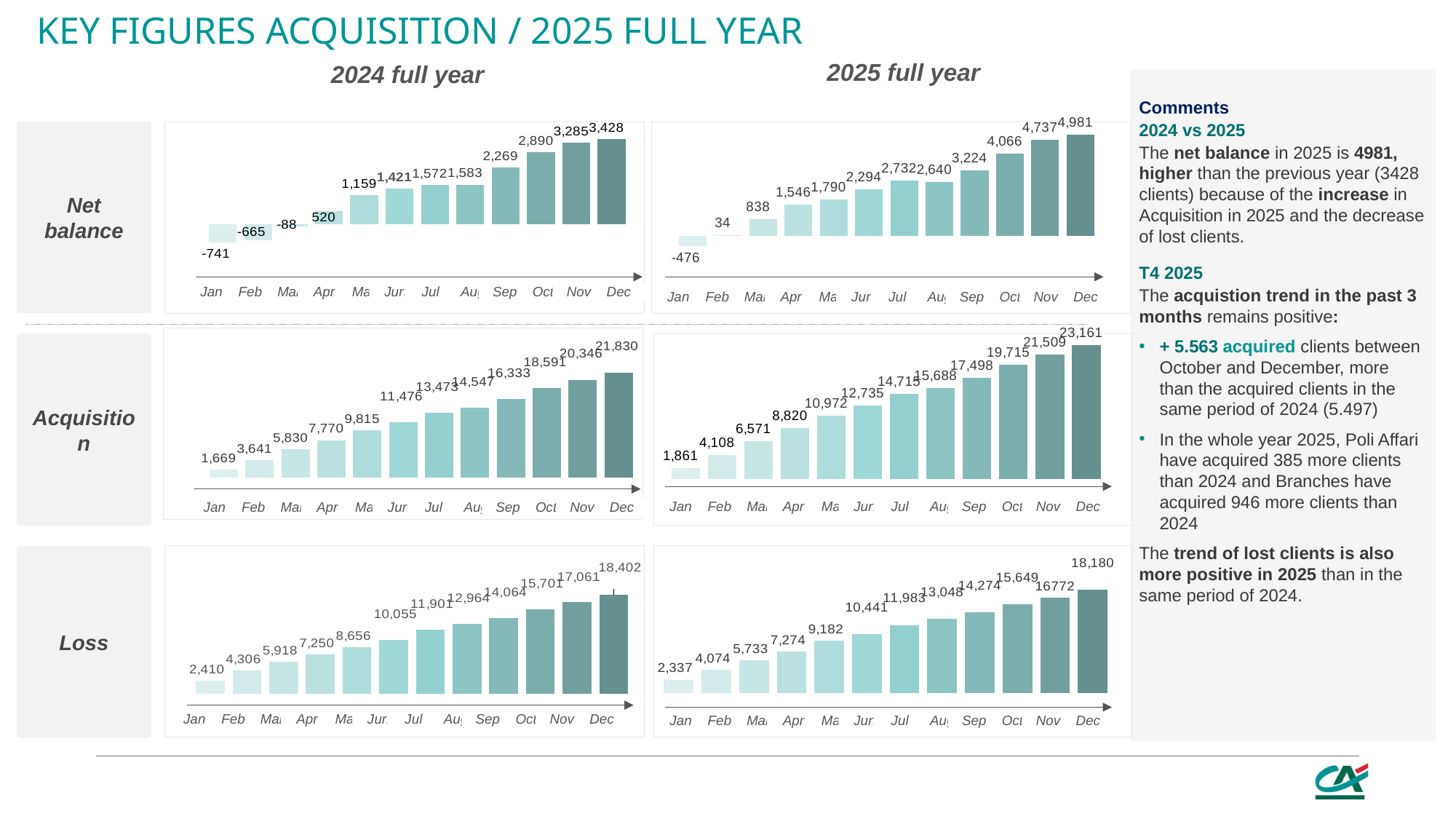
In the Net balance chart for 2025 full year, what is the difference between the Dec and Nov values? 244 Which is larger: the Dec value in the Loss chart for 2024 full year or the Dec value in the Loss chart for 2025 full year? 2024 full year (18,402) In the Acquisition chart for 2025 full year, which month has the highest value? Dec In the Net balance chart for 2024 full year, what is the value for Dec? 3,428 In the Net balance chart for 2024 full year, which month has the lowest value? Jan In the Loss chart for 2025 full year, what is the value for Nov? 16772 In the Net balance chart for 2025 full year, which is larger: the value for Jul or the value for Aug? Jul (2,732) What is the difference between the Dec value in the Acquisition chart for 2025 full year and the Dec value in the Acquisition chart for 2024 full year? 1,331 How many months are plotted in the Acquisition chart for 2024 full year? 12 In the Acquisition chart for 2024 full year, do the values rise or fall from Jan to Dec? Rise In the Net balance chart for 2025 full year, what is the value for Jan? -476 What kind of chart is the Loss chart for 2025 full year? Bar chart